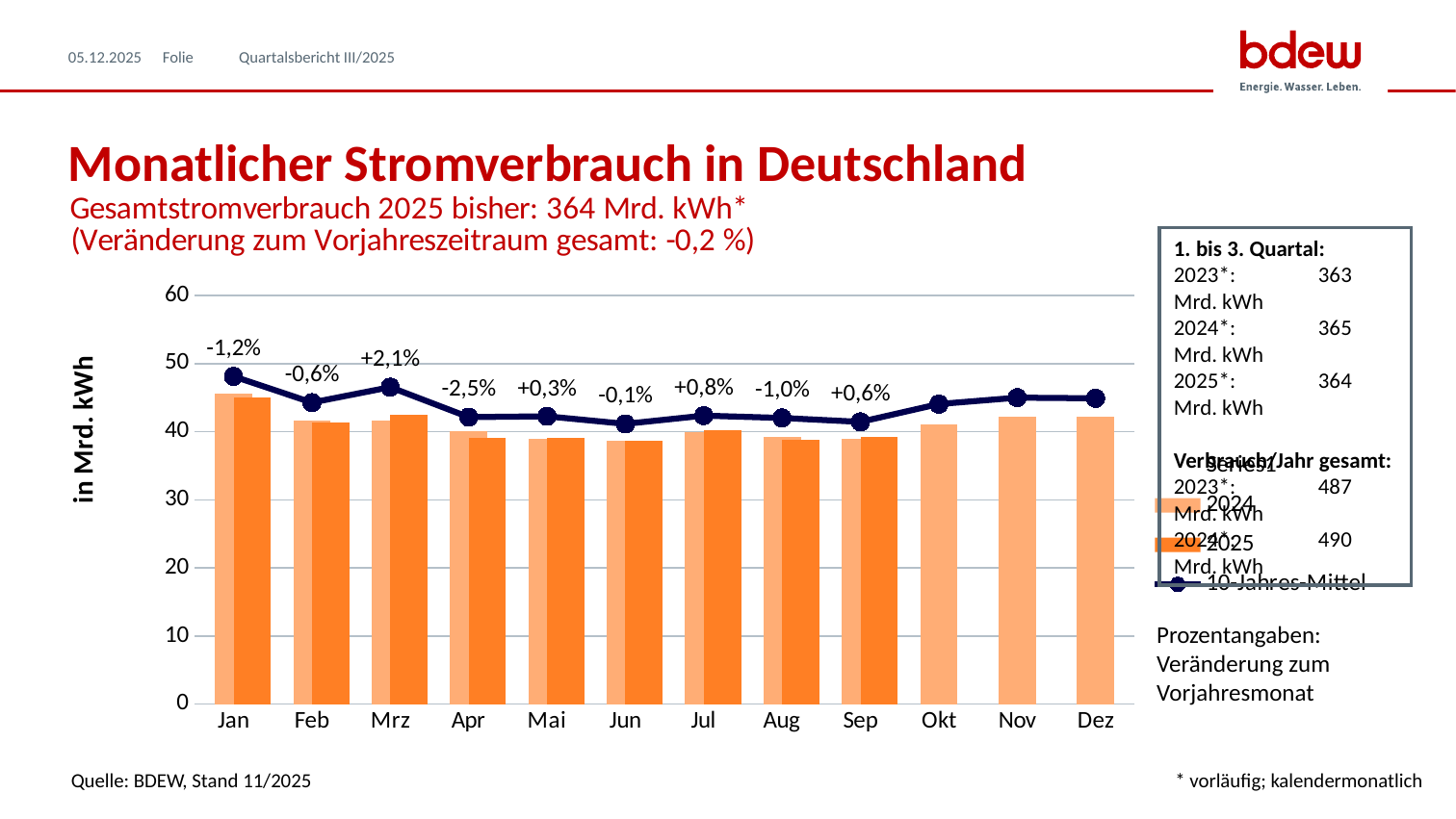
Is the value of the Jun 2025 bar greater or less than 40? less What percentage change is labelled above the bars for Mrz? +2,1% Which month has the lowest labelled percentage change? Apr What percentage change is labelled above the bars for Apr? -2,5% What percentage change is labelled above the bars for Sep? +0,6% What kind of chart is shown on the slide? bar chart with a line Is the value of the Jan 2025 bar greater or less than 40? greater Which is larger, the 2025 bar for Jan or the 2025 bar for Jun? Jan How many months have a percentage change label printed above their bars? 9 How many months are shown on the x axis of the chart? 12 Which month has the highest labelled percentage change? Mrz What is the label on the y axis of the chart? in Mrd. kWh